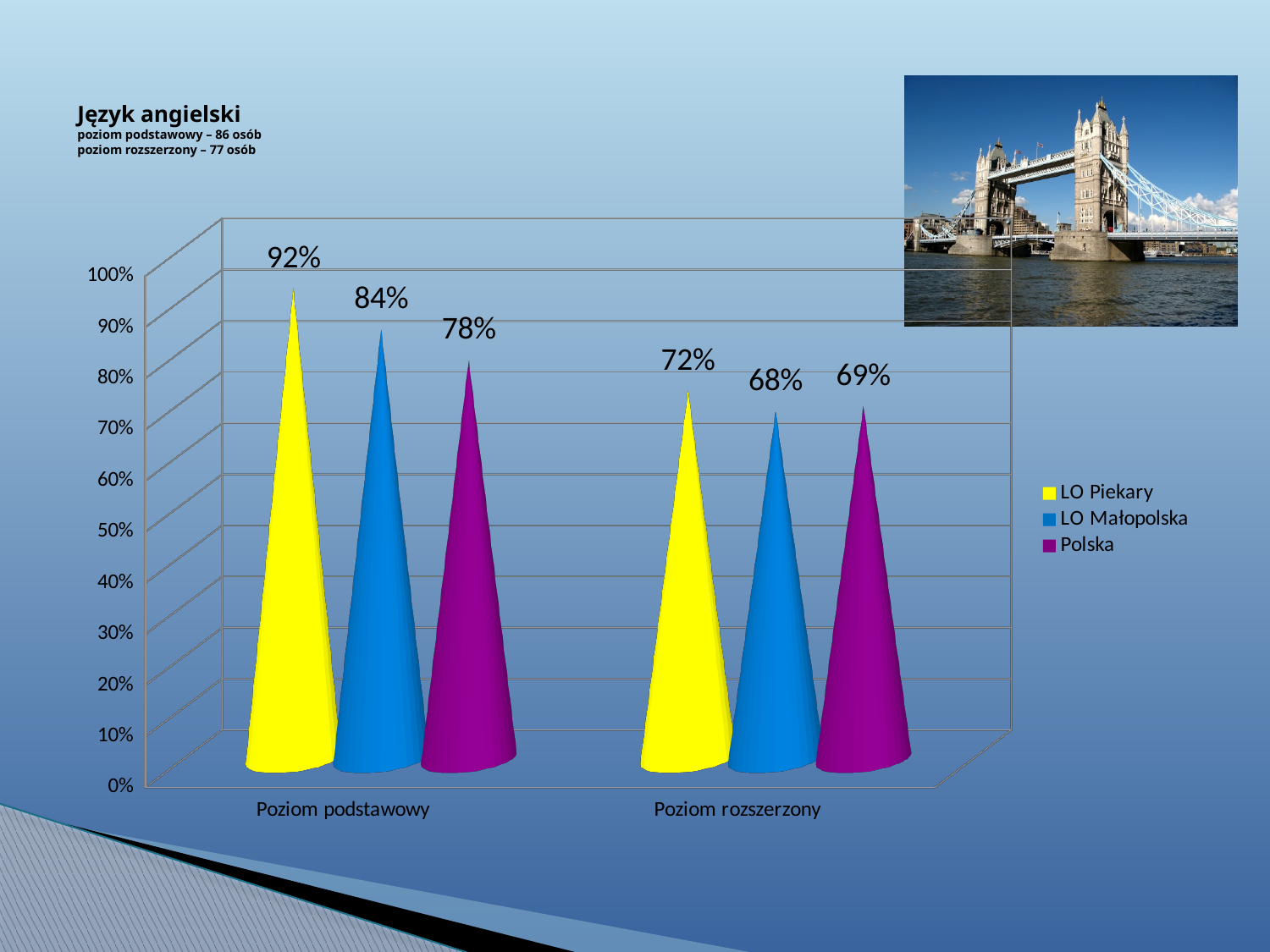
What is the value for Polska at Poziom podstawowy? 78% What is the value for LO Piekary at Poziom rozszerzony? 72% Which is larger: LO Małopolska at Poziom podstawowy or Polska at Poziom podstawowy? LO Małopolska at Poziom podstawowy What is the value for LO Małopolska at Poziom rozszerzony? 68% What is the difference between LO Piekary at Poziom podstawowy and LO Piekary at Poziom rozszerzony? 20% What is the difference between LO Piekary and Polska at Poziom podstawowy? 14% What is the value for LO Piekary at Poziom podstawowy? 92% What kind of chart is shown on the slide? Bar chart How many series does the legend list? 3 Which series has the lowest value at Poziom rozszerzony? LO Małopolska How many categories are shown on the x axis? 2 Which series has the highest value at Poziom podstawowy? LO Piekary